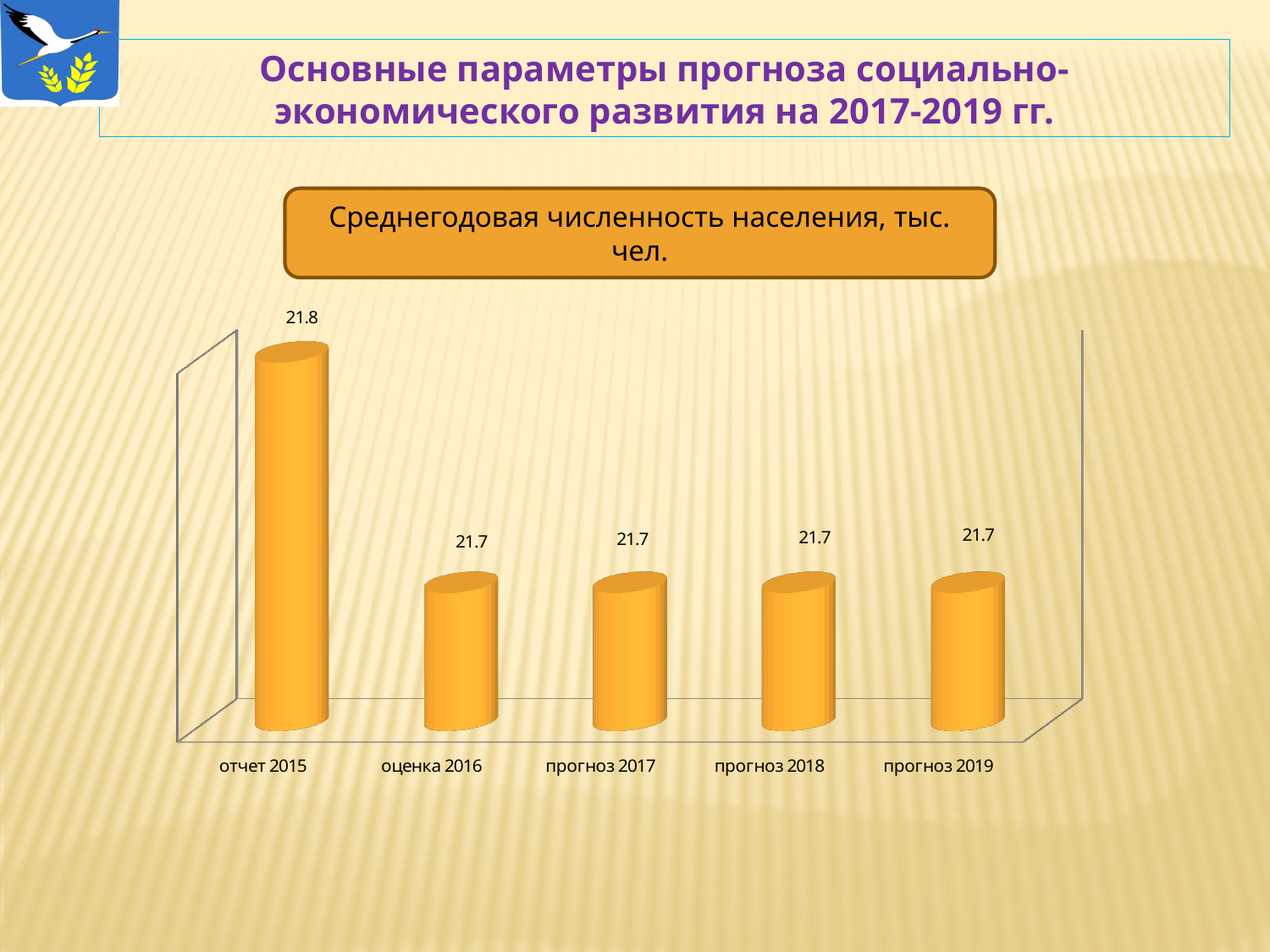
What is the value for отчет 2015? 21.8 Do the values rise or fall from отчет 2015 to оценка 2016? fall Which category has the highest value? отчет 2015 What is the title of the chart? Среднегодовая численность населения, тыс. чел. What kind of chart is shown on the slide? bar chart How many categories are shown on the x axis? 5 What is the value for оценка 2016? 21.7 What is the value for прогноз 2018? 21.7 Which is larger, the value for отчет 2015 or the value for прогноз 2018? отчет 2015 What is the difference between the values for отчет 2015 and прогноз 2017? 0.1 What is the value for прогноз 2019? 21.7